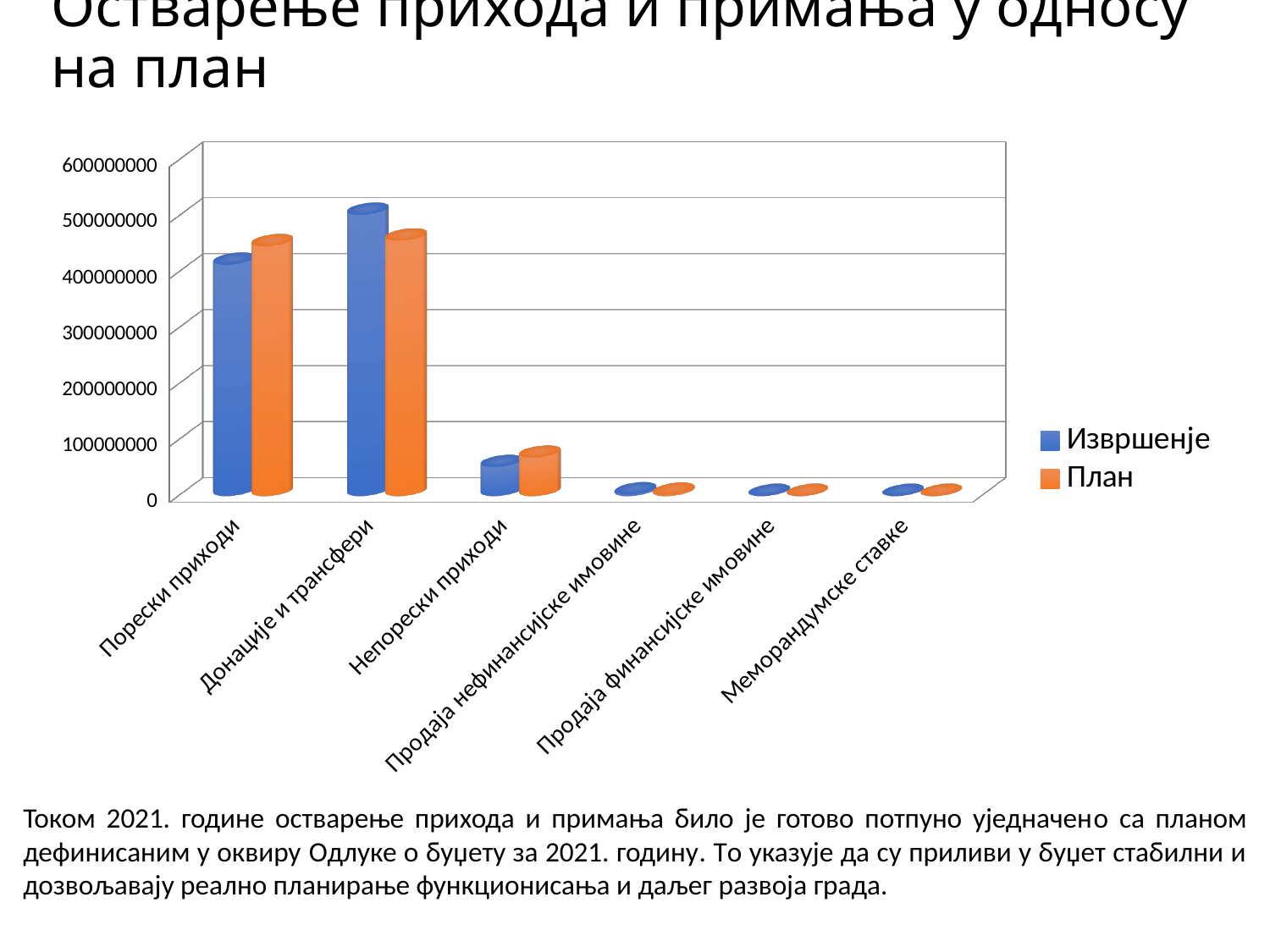
Is the План value for Порески приходи greater or less than 400000000? greater Which category has the highest План value? Донације и трансфери How many categories are shown on the x axis? 6 For Непорески приходи, which is larger: Извршење or План? План What are the two series named in the legend? Извршенје and План For Порески приходи, which is larger: Извршење or План? План How many series does the legend list? 2 Is the Извршење value for Донације и трансфери greater or less than 400000000? greater Is the Извршење value for Непорески приходи greater or less than 100000000? less For Донације и трансфери, which is larger: Извршење or План? Извршење Which category has the highest Извршење value? Донације и трансфери What kind of chart is shown on the slide? bar chart